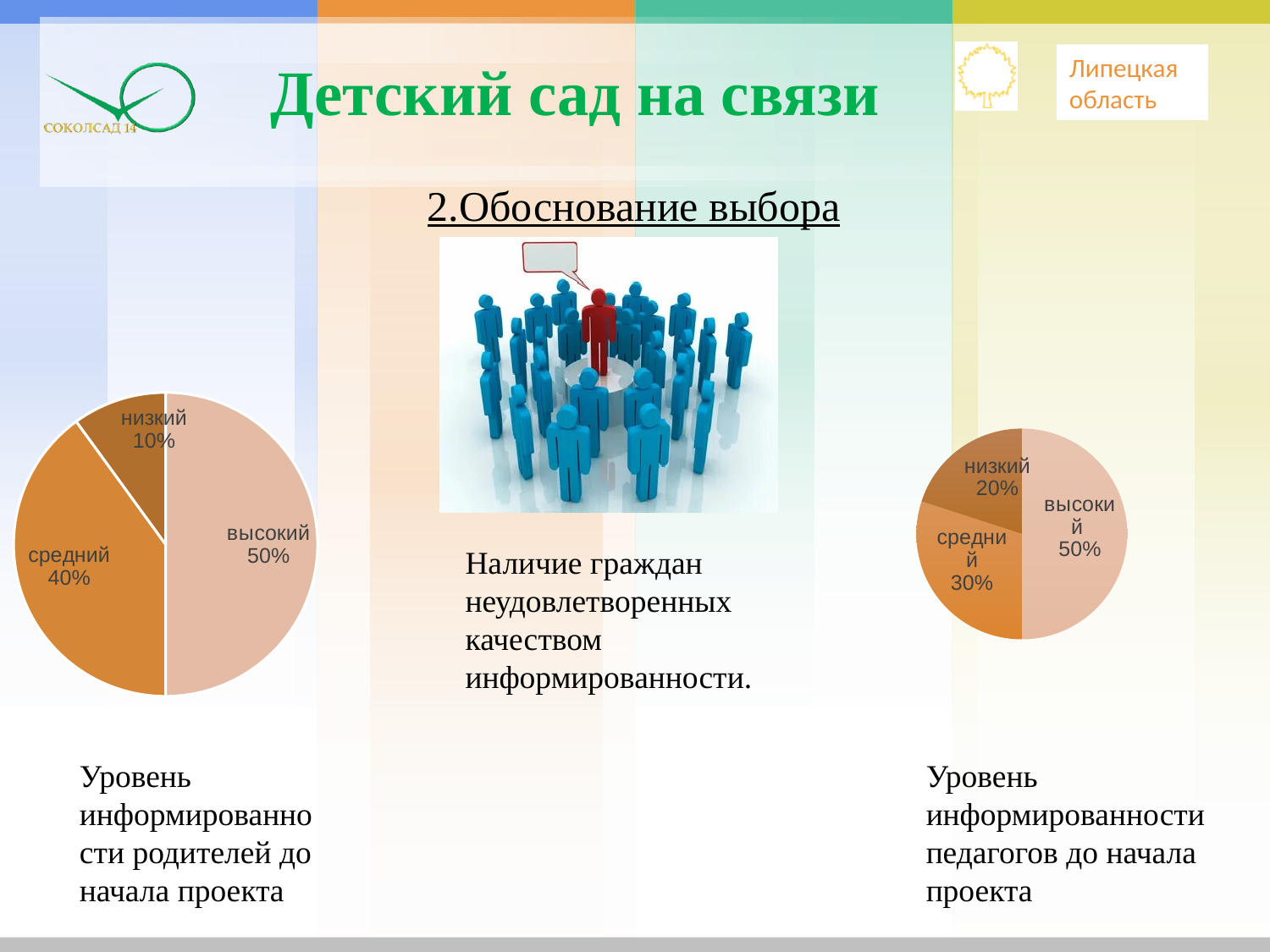
What type of chart is used on the right side of the slide for teachers' awareness level? pie chart In the right pie chart (teachers' awareness level before the project), what share is labelled 'средний'? 30% In the left pie chart (parents' awareness level before the project), what share is labelled 'средний'? 40% In the right pie chart (teachers' awareness level), which category has the largest slice? высокий In the left pie chart (parents' awareness level), which category has the smallest slice? низкий In the left pie chart (parents' awareness level), what is the difference between the 'средний' and 'низкий' shares? 30% How many slices does the left pie chart (parents' awareness level) have? 3 In the right pie chart (teachers' awareness level), what is the difference between the 'высокий' and 'средний' shares? 20% In the left pie chart (parents' awareness level before the project), what share is labelled 'высокий'? 50% In the right pie chart (teachers' awareness level before the project), what share is labelled 'низкий'? 20% Which is larger: the 'низкий' share in the left pie chart (parents) or the 'низкий' share in the right pie chart (teachers)? the right pie chart (teachers) In the left pie chart (parents' awareness level before the project), what share is labelled 'низкий'? 10%